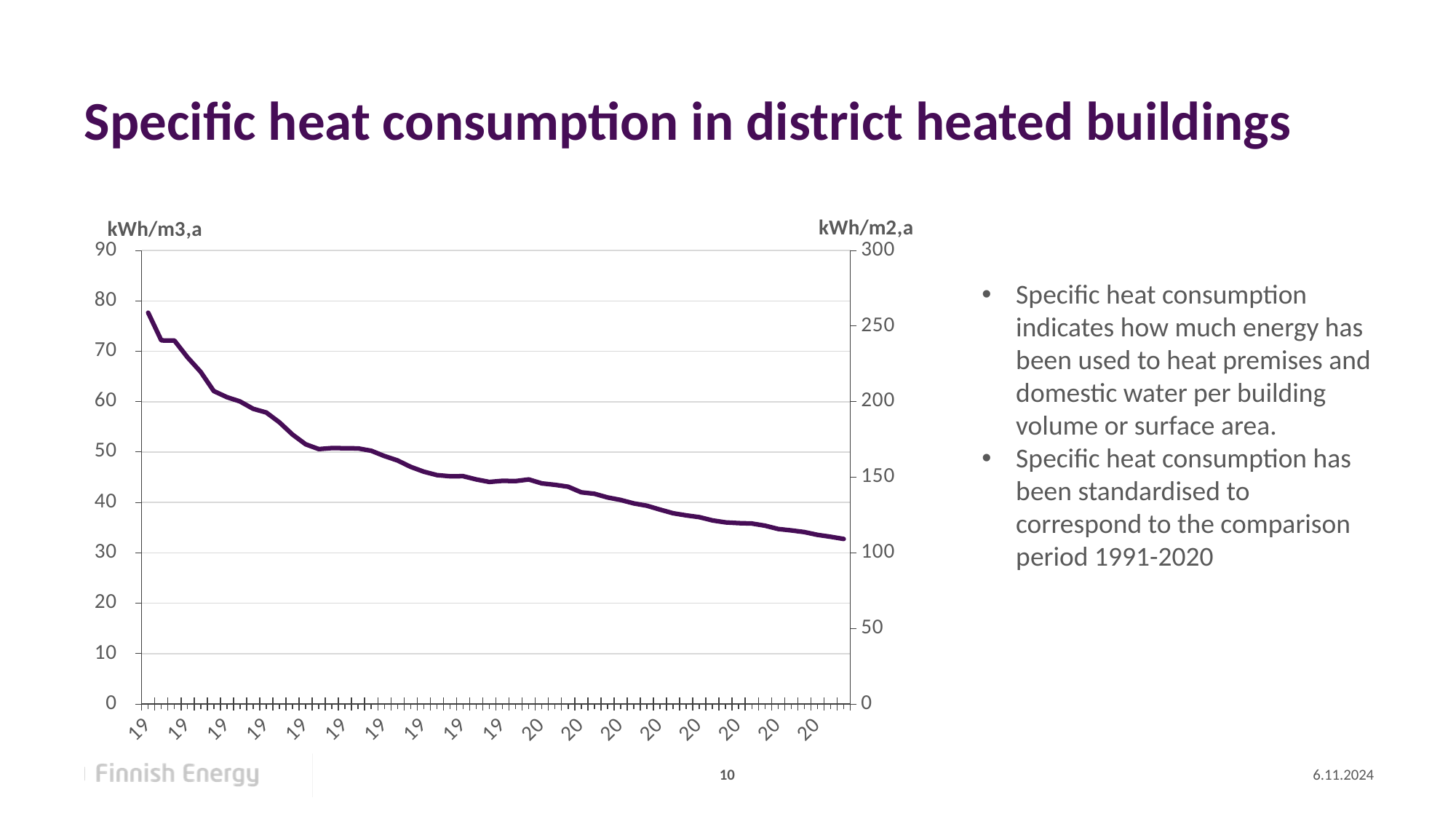
Is the value at the rightmost point of the line greater or less than 40 on the left axis? less What unit is shown on the left vertical axis of the chart? kWh/m3,a Is the value at the leftmost point of the line greater or less than 80 on the left axis? less Is the value at the leftmost point of the line greater or less than 250 on the right axis? greater What is the title of the slide containing the chart? Specific heat consumption in district heated buildings What kind of chart is shown on the slide? line chart Do the values on the chart rise or fall along the x axis from left to right? fall Which is larger, the value at the leftmost point of the line or the value at the rightmost point? the leftmost point